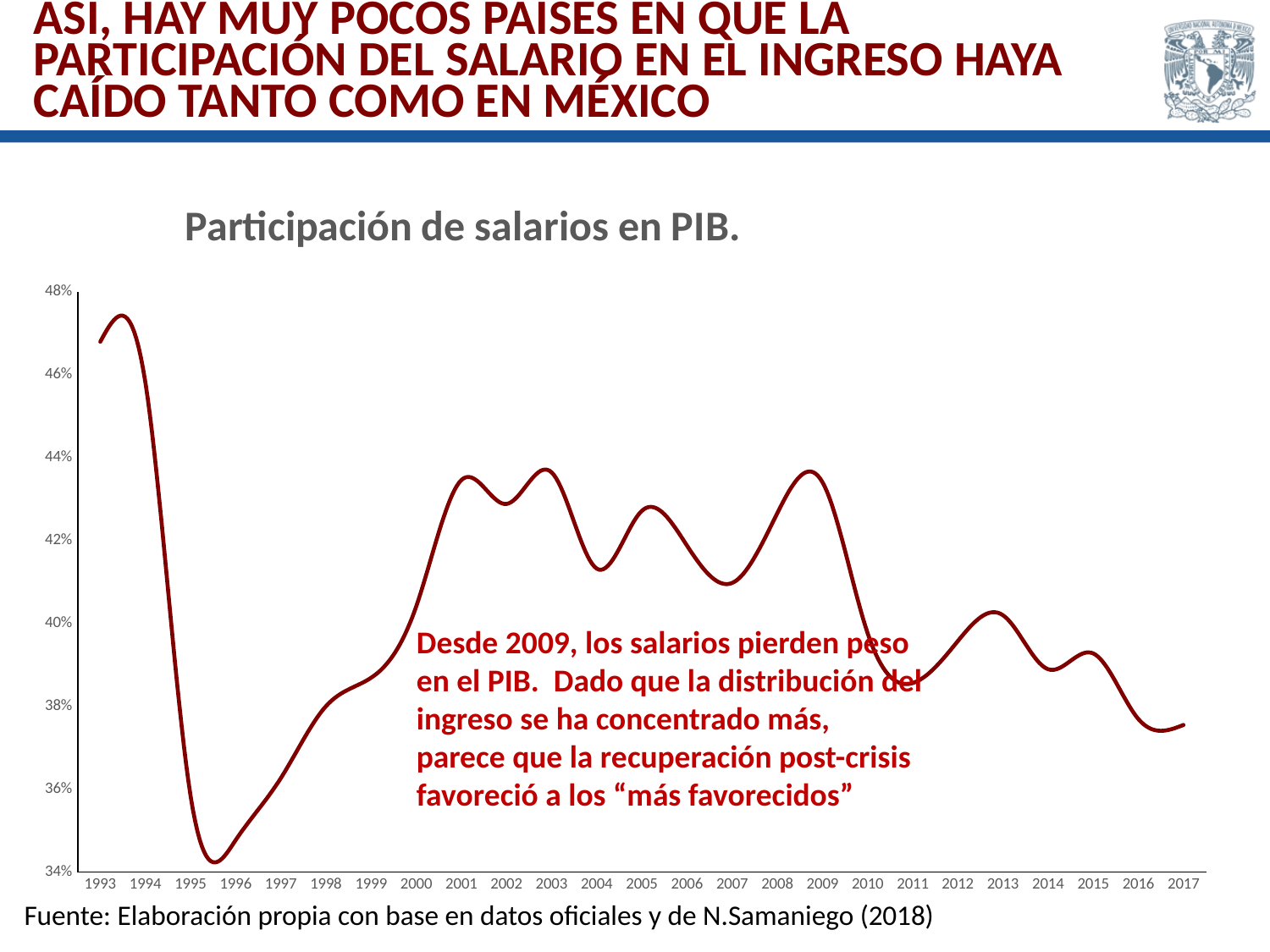
Which year has the larger value, 2003 or 2011? 2003 In which year does the line reach its highest value? 1993 Is the value for 2017 greater or less than 38%? less Does the line rise or fall between 2013 and 2017? fall What is the title of the chart? Participación de salarios en PIB. Is the value for 2004 greater or less than 42%? less Which year has the larger value, 1994 or 2017? 1994 Is the value for 2011 greater or less than 40%? less What kind of chart is shown on the slide? line chart How many years are labelled on the x axis of the chart? 25